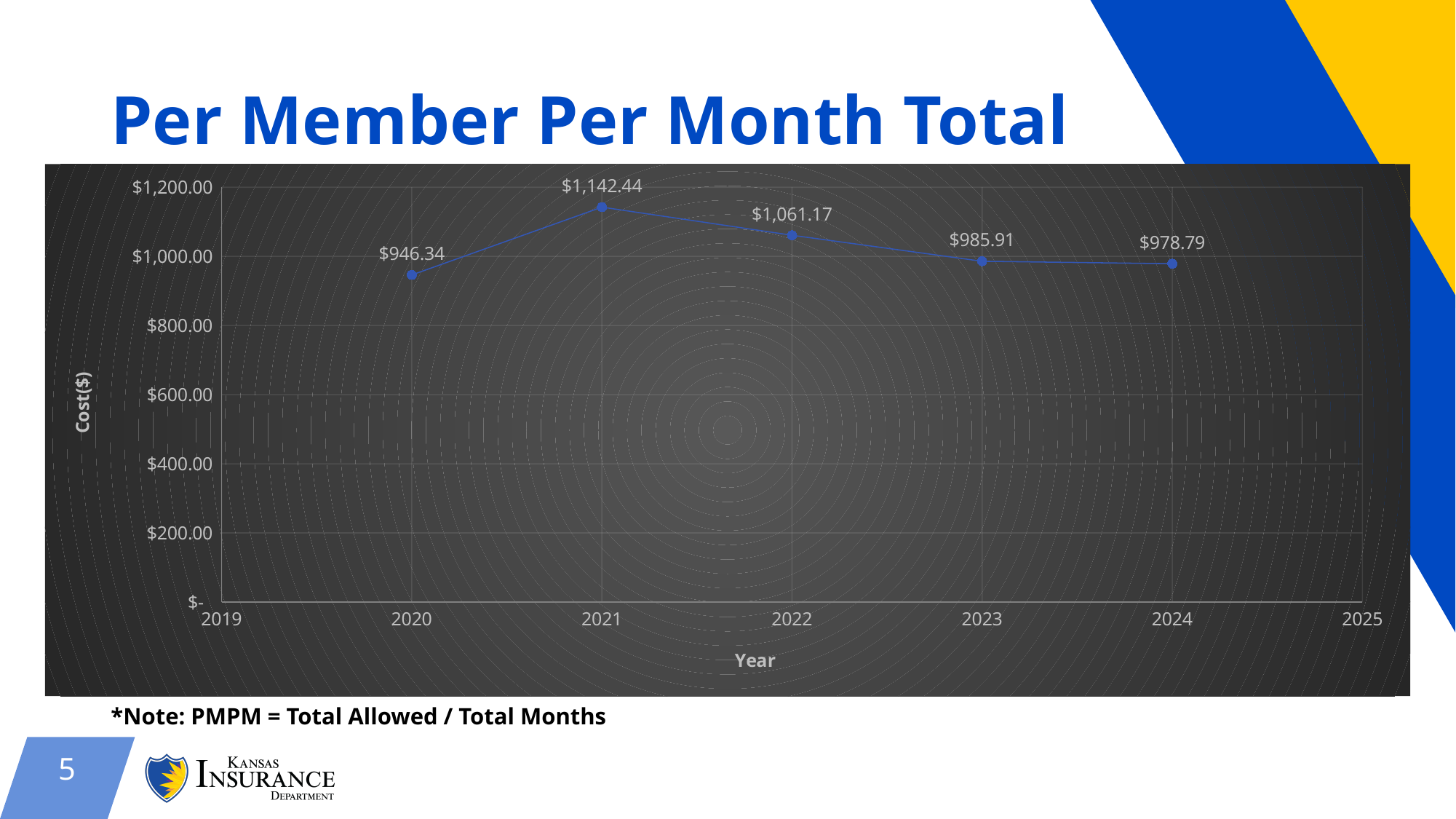
Is the Per Member Per Month Total for 2020 greater or less than $1,000.00? less Which year has a larger Per Member Per Month Total, 2022 or 2023? 2022 What is the difference between the 2021 and 2020 Per Member Per Month Total values? $196.10 What is the Per Member Per Month Total value for 2020? $946.34 Which year has the highest Per Member Per Month Total? 2021 Does the Per Member Per Month Total rise or fall from 2021 to 2024? fall How many data points are plotted on the Per Member Per Month Total chart? 5 What is the difference between the 2022 and 2023 Per Member Per Month Total values? $75.26 What kind of chart is shown on the slide? line chart What is the Per Member Per Month Total value for 2021? $1,142.44 What is the Per Member Per Month Total value for 2024? $978.79 Which year has the lowest Per Member Per Month Total? 2020